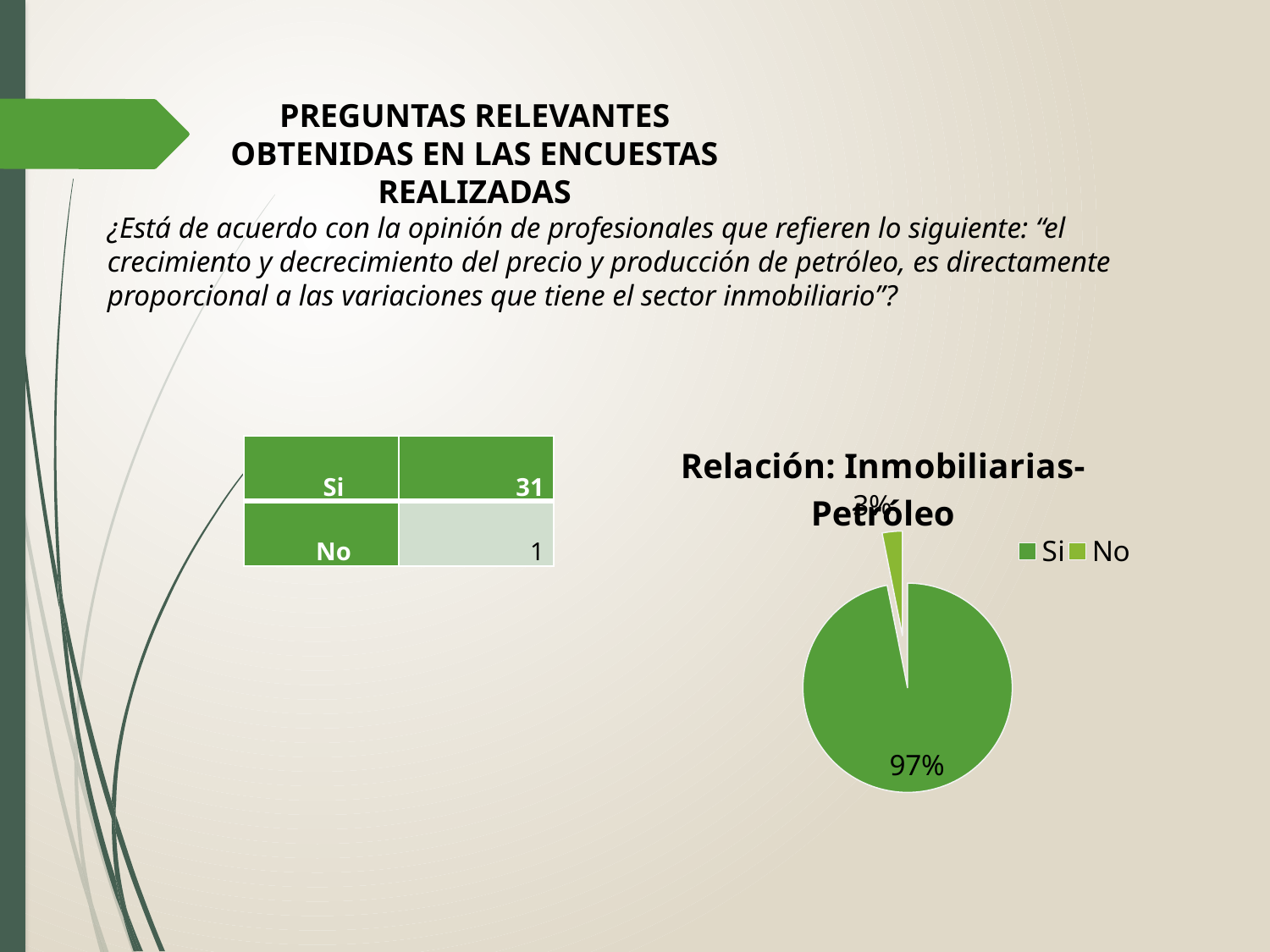
What is the difference in percentage points between the "Si" slice and the "No" slice in the pie chart? 94% Is the share of the "Si" slice in the pie chart greater or less than 50%? greater What is the title of the pie chart? Relación: Inmobiliarias-Petróleo Which category has the smallest slice in the pie chart? No What kind of chart is shown on the slide? pie chart Which category has the largest slice in the pie chart? Si What share of the pie chart does the "Si" slice represent? 97% How many entries does the legend of the pie chart list? 2 What share of the pie chart does the "No" slice represent? 3% What are the two legend entries of the pie chart? Si and No How many slices does the pie chart have? 2 Which slice is larger in the pie chart, "Si" or "No"? Si